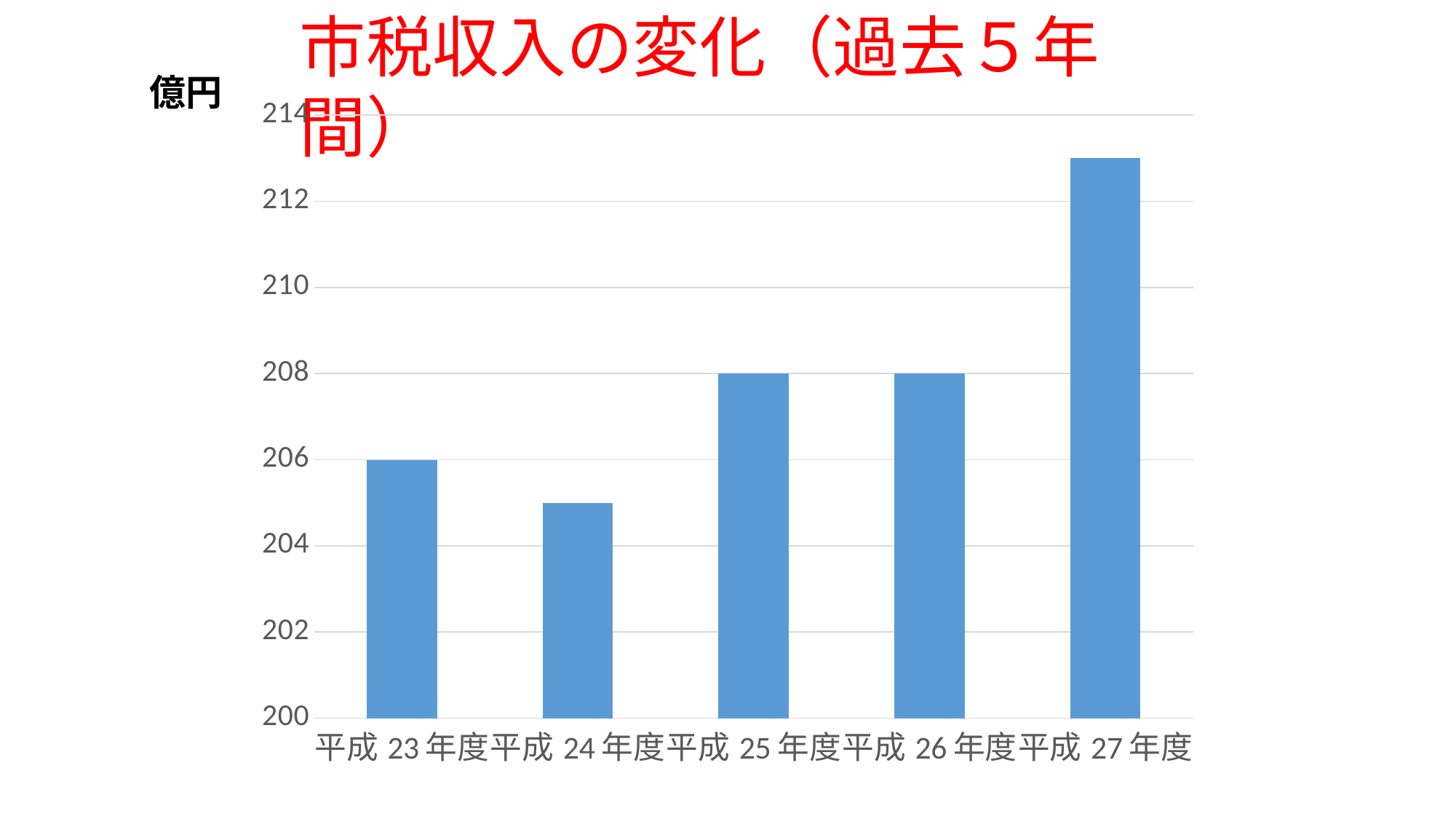
What is the value for 平成23年度? 206 Is the value for 平成27年度 greater or less than 212? greater What kind of chart is shown on the slide? bar chart Which year has the highest value? 平成27年度 Which year has the lowest value? 平成24年度 Which is larger, the value for 平成23年度 or 平成24年度? 平成23年度 What unit is shown at the top of the vertical axis? 億円 What is the difference between the values for 平成25年度 and 平成23年度? 2 What is the value for 平成26年度? 208 Is the value for 平成24年度 greater or less than 206? less What is the value for 平成25年度? 208 How many years are shown on the chart? 5